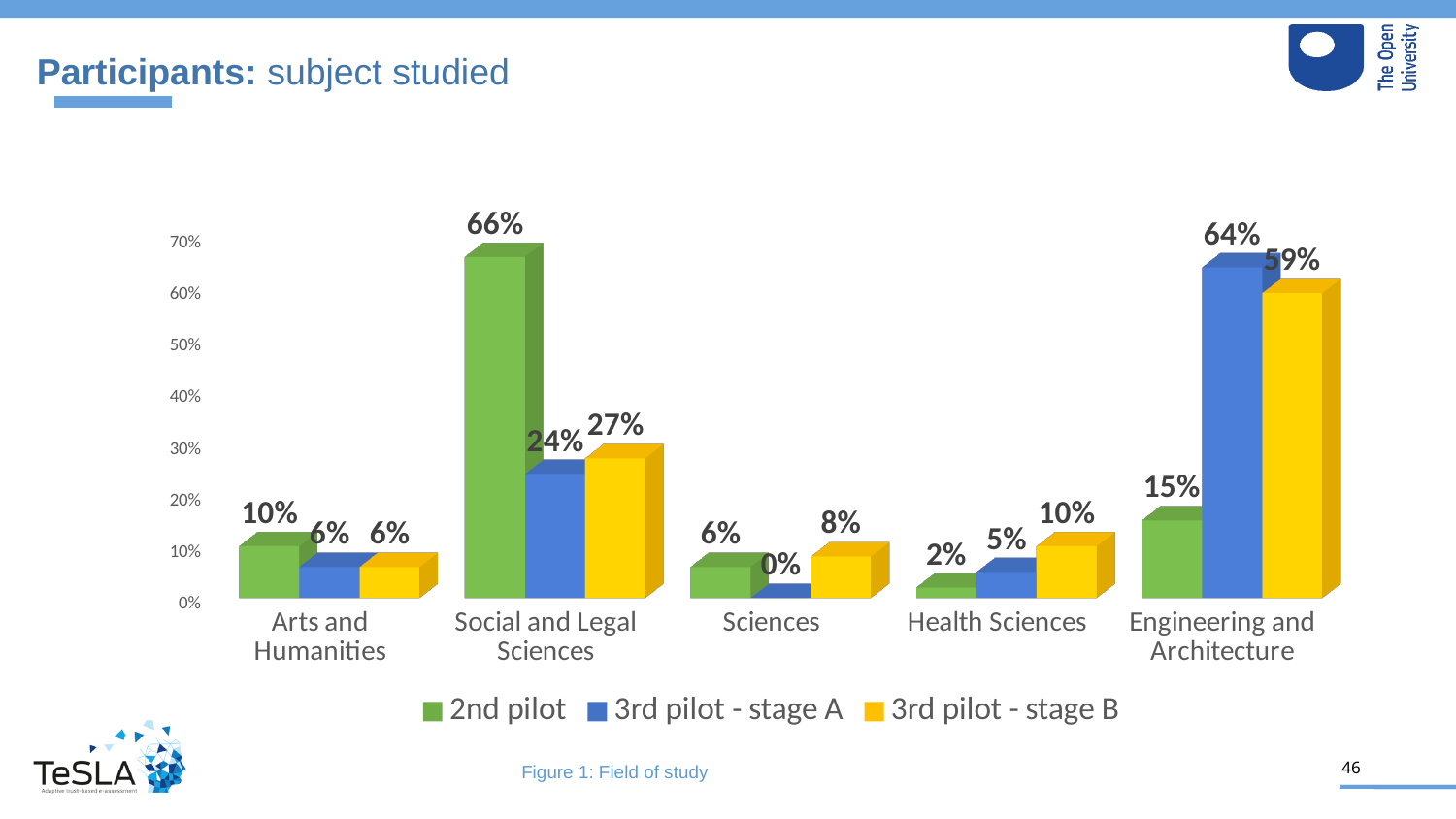
What is the difference between the 2nd pilot and 3rd pilot - stage A values for Social and Legal Sciences? 42% What is the value for Health Sciences in the 3rd pilot - stage A series? 5% What kind of chart is shown on the slide? Bar chart Is the 2nd pilot value for Social and Legal Sciences greater or less than 60%? greater What is the value for Social and Legal Sciences in the 2nd pilot series? 66% Which colour represents the 3rd pilot - stage B series? Yellow Which is larger for Engineering and Architecture: the 3rd pilot - stage A value or the 3rd pilot - stage B value? 3rd pilot - stage A Which category has the lowest value in the 2nd pilot series? Health Sciences How many series does the legend list? 3 Which category has the highest value in the 3rd pilot - stage A series? Engineering and Architecture How many subject categories are shown on the x axis? 5 What is the value for Engineering and Architecture in the 3rd pilot - stage B series? 59%